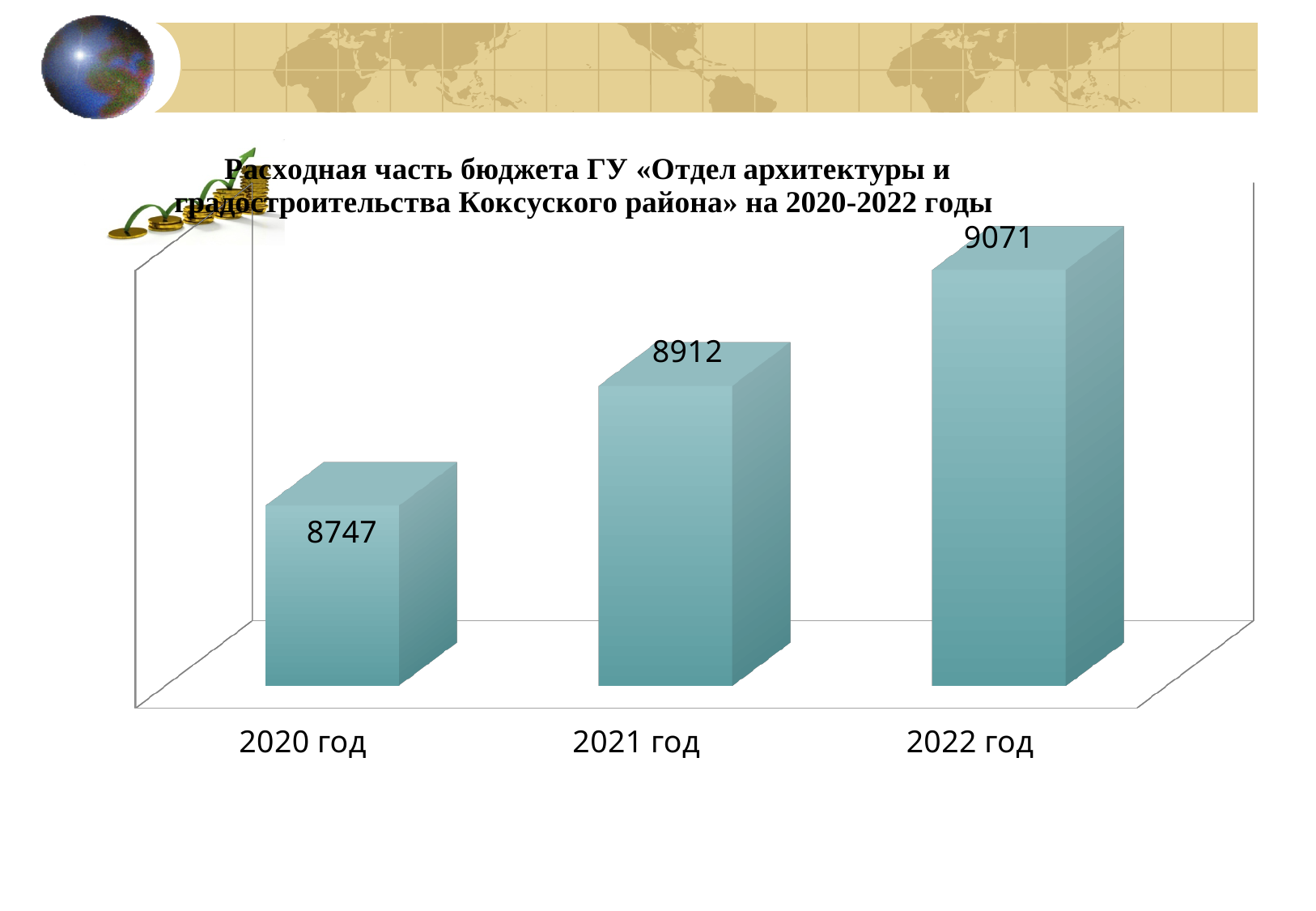
Which year has the lowest value? 2020 год What is the difference between the values for 2022 год and 2020 год? 324 What is the value for 2022 год? 9071 Which year has the highest value? 2022 год What kind of chart is shown on the slide? bar chart What is the difference between the values for 2021 год and 2020 год? 165 Which is larger, the value for 2021 год or the value for 2020 год? 2021 год What is the difference between the values for 2022 год and 2021 год? 159 What is the value for 2021 год? 8912 How many years are shown on the chart? 3 What is the value for 2020 год? 8747 Do the values rise or fall from 2020 год to 2022 год? rise